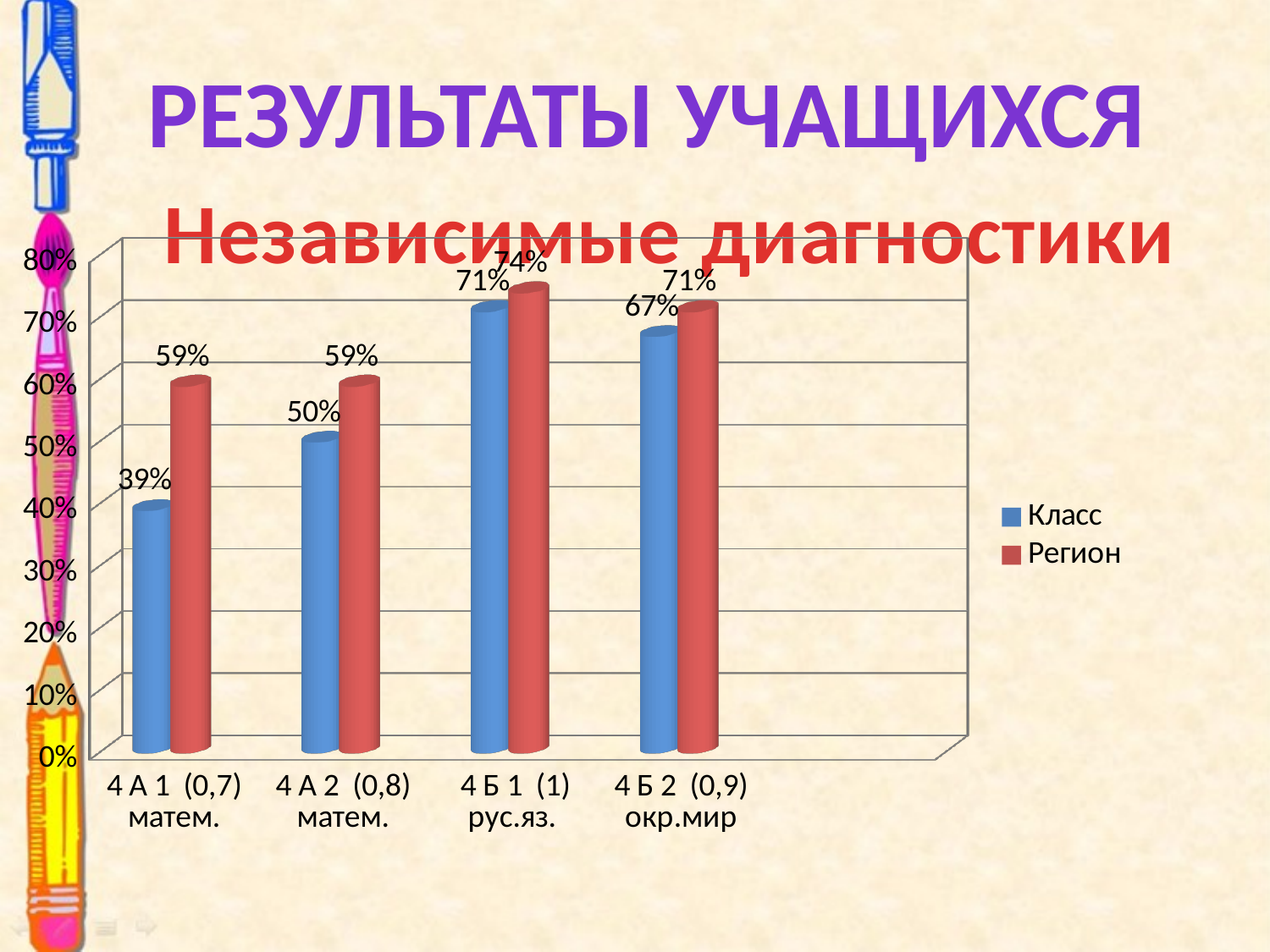
What is the value for Регион in the category 4 Б 1 (1) рус.яз.? 74% Which category has the lowest value for the Класс series? 4 А 1 (0,7) матем. What is the difference between the Регион and Класс values in the category 4 А 1 (0,7) матем.? 20% What kind of chart is shown on the slide? bar chart Is the value for Класс in the category 4 А 2 (0,8) матем. greater or less than 60%? less How many categories are shown on the x axis of the chart? 4 What is the value for Класс in the category 4 А 1 (0,7) матем.? 39% Which is larger in the category 4 А 2 (0,8) матем.: the Класс value or the Регион value? Регион Which category has the highest value for the Класс series? 4 Б 1 (1) рус.яз. What is the title of the chart? Независимые диагностики What is the value for Класс in the category 4 Б 2 (0,9) окр.мир? 67% How many series does the legend list? 2